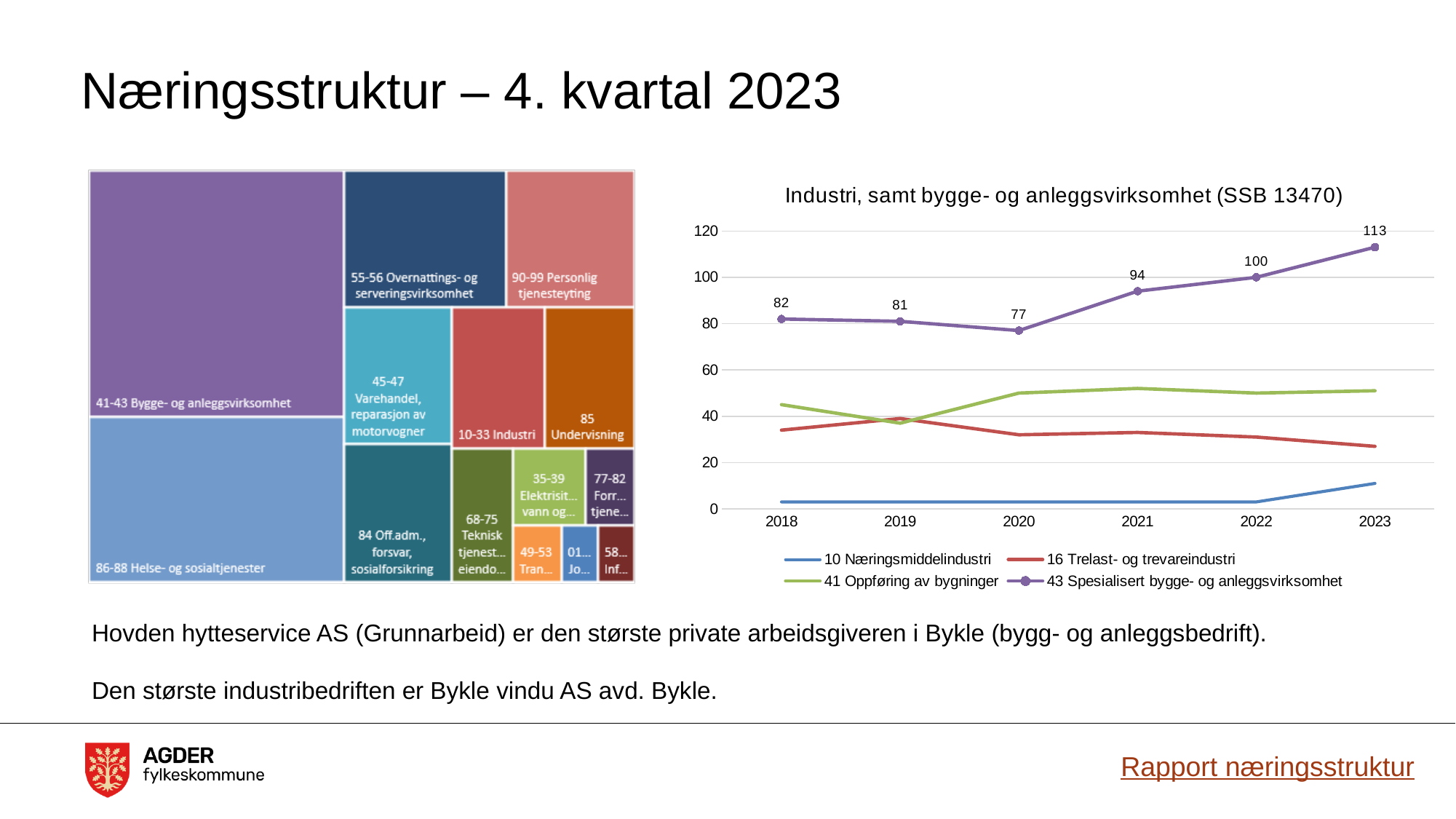
In the line chart 'Industri, samt bygge- og anleggsvirksomhet (SSB 13470)', is the value for 41 Oppføring av bygninger in 2023 greater or less than 40? greater In the line chart 'Industri, samt bygge- og anleggsvirksomhet (SSB 13470)', which year has the larger value for 43 Spesialisert bygge- og anleggsvirksomhet, 2019 or 2021? 2021 In the line chart 'Industri, samt bygge- og anleggsvirksomhet (SSB 13470)', how many series does the legend list? 4 In the line chart 'Industri, samt bygge- og anleggsvirksomhet (SSB 13470)', is the value for 10 Næringsmiddelindustri in 2018 greater or less than 20? less What kind of chart is the chart on the right of the slide, titled 'Industri, samt bygge- og anleggsvirksomhet (SSB 13470)'? line chart In the line chart 'Industri, samt bygge- og anleggsvirksomhet (SSB 13470)', in which year is the value for 43 Spesialisert bygge- og anleggsvirksomhet highest? 2023 In the line chart 'Industri, samt bygge- og anleggsvirksomhet (SSB 13470)', what is the value for 43 Spesialisert bygge- og anleggsvirksomhet in 2020? 77 In the line chart 'Industri, samt bygge- og anleggsvirksomhet (SSB 13470)', what is the value for 43 Spesialisert bygge- og anleggsvirksomhet in 2023? 113 In the line chart 'Industri, samt bygge- og anleggsvirksomhet (SSB 13470)', does the value for 43 Spesialisert bygge- og anleggsvirksomhet rise or fall from 2020 to 2023? rise In the line chart 'Industri, samt bygge- og anleggsvirksomhet (SSB 13470)', by how much did the value for 43 Spesialisert bygge- og anleggsvirksomhet increase from 2018 to 2023? 31 In the line chart 'Industri, samt bygge- og anleggsvirksomhet (SSB 13470)', in which year is the value for 43 Spesialisert bygge- og anleggsvirksomhet lowest? 2020 In the line chart 'Industri, samt bygge- og anleggsvirksomhet (SSB 13470)', how many years are shown on the x axis? 6